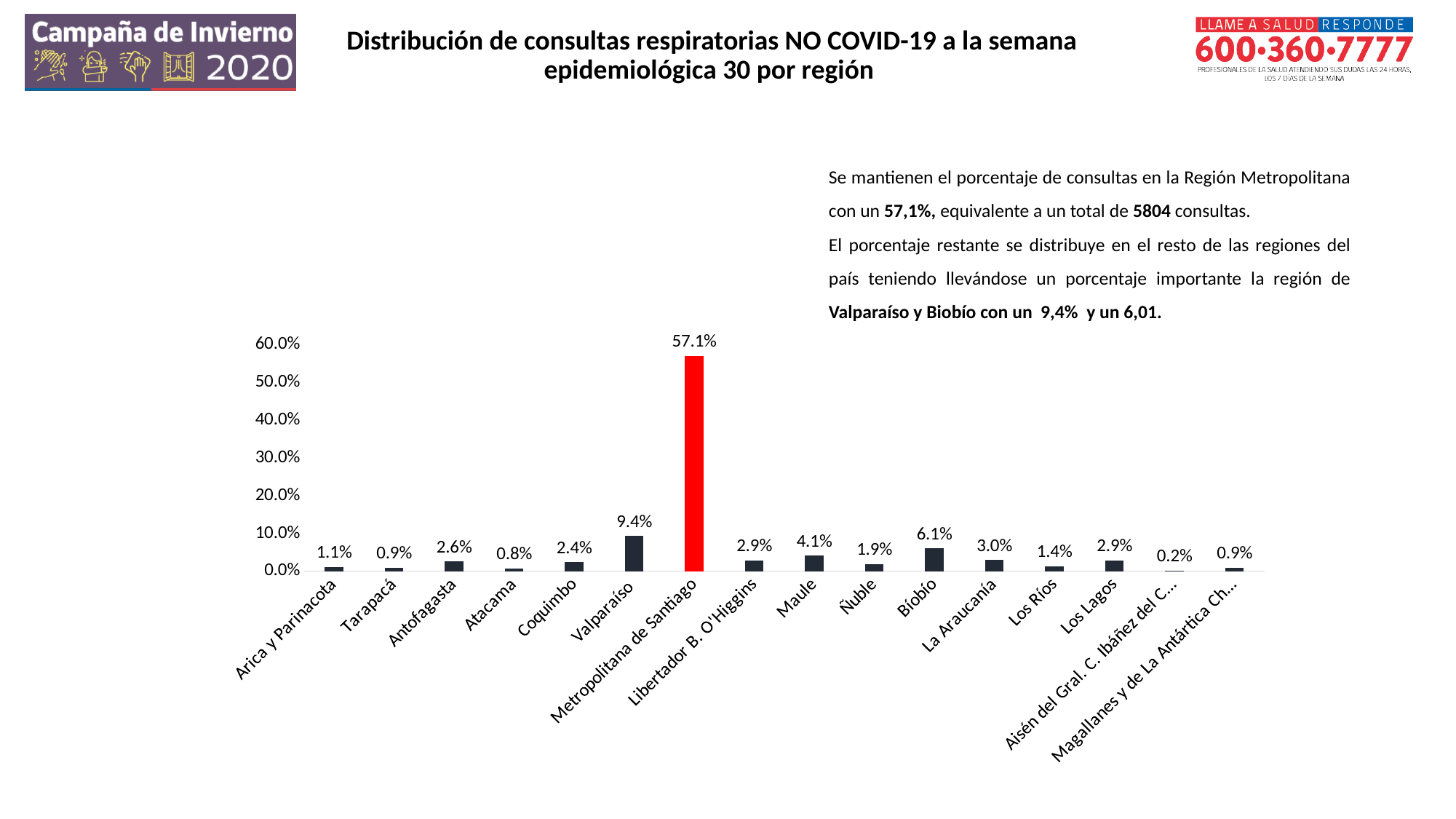
Which region has the highest value? Metropolitana de Santiago Which bar is coloured red? Metropolitana de Santiago What is the value for Valparaíso? 9.4% Is the value for Metropolitana de Santiago greater or less than 50.0%? greater Which is larger, the value for Biobío or the value for Maule? Biobío Which region has the lowest value? Aisén del Gral. C. Ibáñez del C... What is the value for Metropolitana de Santiago? 57.1% What is the difference between the values for Metropolitana de Santiago and Valparaíso? 47.7% How many regions are shown on the x axis? 16 What is the value for Biobío? 6.1% What kind of chart is shown? bar chart What is the value for Maule? 4.1%